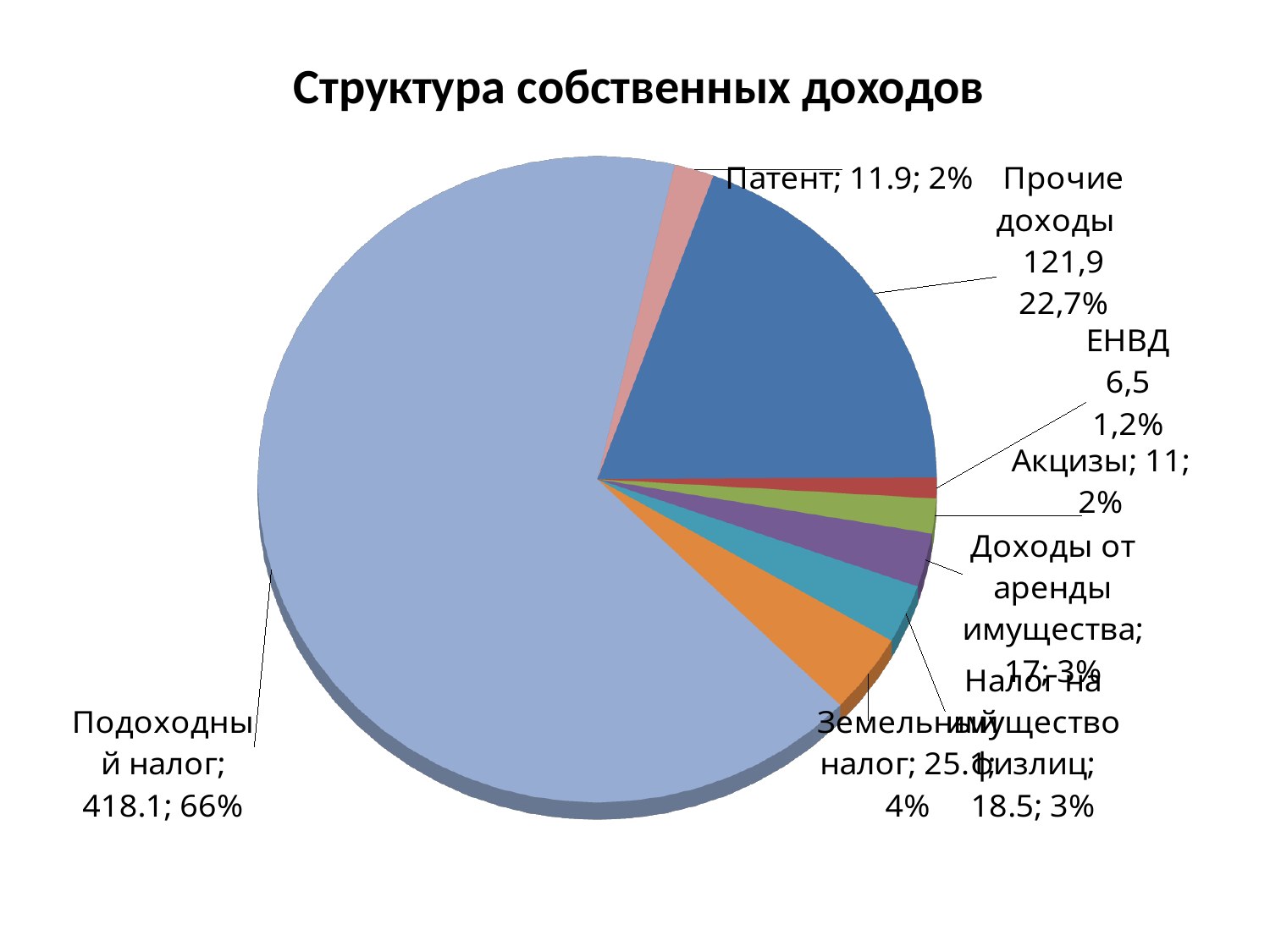
What is the title of the chart? Структура собственных доходов What share of the pie does Прочие доходы represent? 22,7% What share of the pie does Подоходный налог represent? 66% Which category has the largest slice of the pie? Подоходный налог What is the value shown for Прочие доходы? 121,9 Which is larger, the value for Земельный налог or the value for Налог на имущество физлиц? Земельный налог What kind of chart is shown on the slide? pie chart What is the value shown for Подоходный налог? 418.1 What is the value shown for Земельный налог? 25.1 What is the value shown for ЕНВД? 6,5 Which category has the smallest slice of the pie? ЕНВД How many slices does the pie chart have? 8